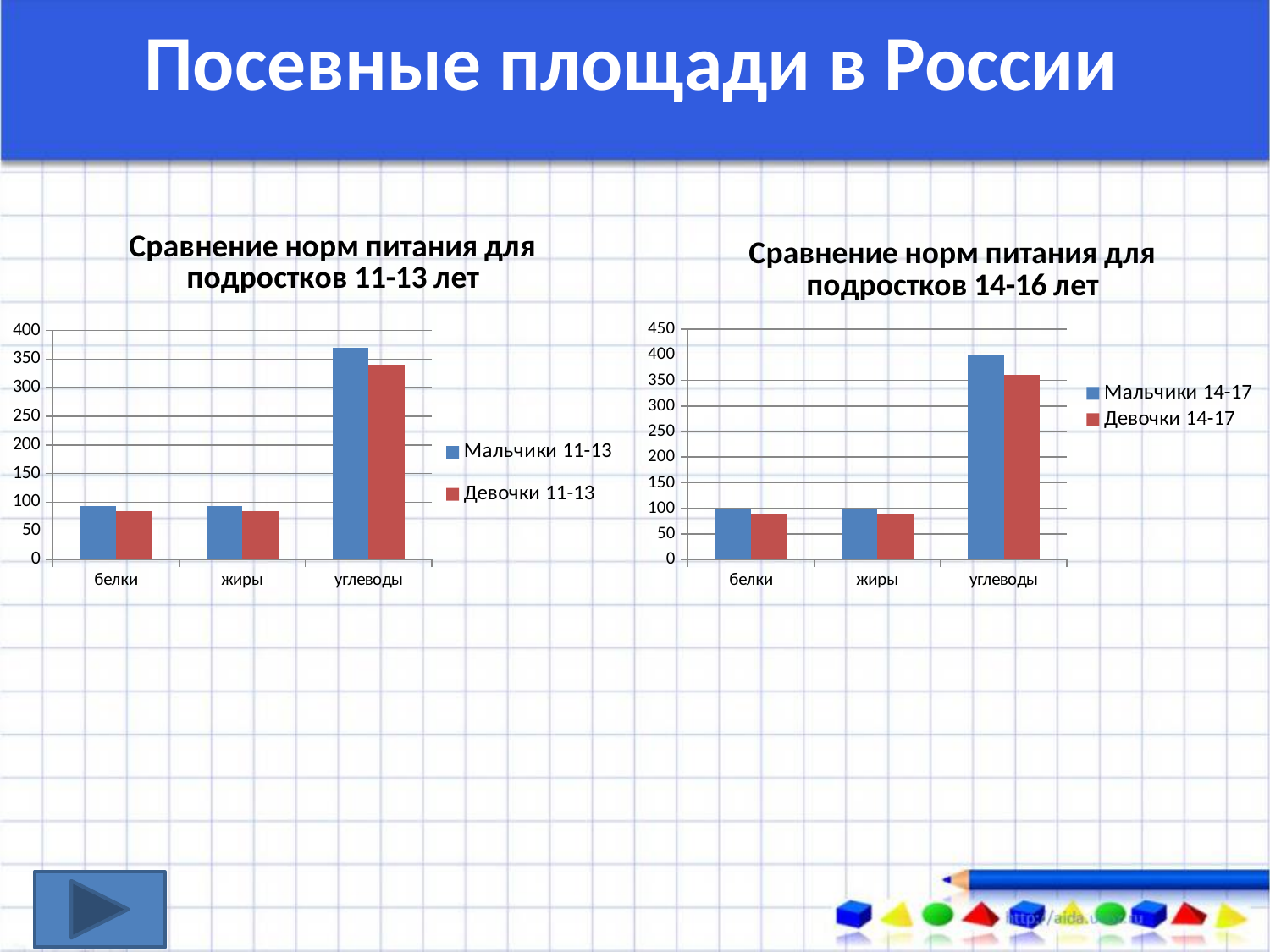
What kind of chart is the left chart, 'Сравнение норм питания для подростков 11-13 лет'? bar chart In the right chart ('подростков 14-16 лет'), is the value for Девочки 14-17 in углеводы greater or less than 400? less What is the title of the right chart? Сравнение норм питания для подростков 14-16 лет How many series does the legend of the left chart ('подростков 11-13 лет') list? 2 In the right chart ('подростков 14-16 лет'), which category has the highest value for Девочки 14-17? углеводы What are the legend entries of the right chart ('подростков 14-16 лет')? Мальчики 14-17, Девочки 14-17 How many categories are shown on the x axis of the left chart ('подростков 11-13 лет')? 3 In the left chart ('подростков 11-13 лет'), which series has the larger value for углеводы: Мальчики 11-13 or Девочки 11-13? Мальчики 11-13 In the left chart ('подростков 11-13 лет'), which category has the highest value for Мальчики 11-13? углеводы In the right chart ('подростков 14-16 лет'), what is the value for Мальчики 14-17 in углеводы? 400 In the left chart ('подростков 11-13 лет'), is the value for Девочки 11-13 in углеводы greater or less than 300? greater In the left chart ('подростков 11-13 лет'), is the value for Мальчики 11-13 in белки greater or less than 150? less